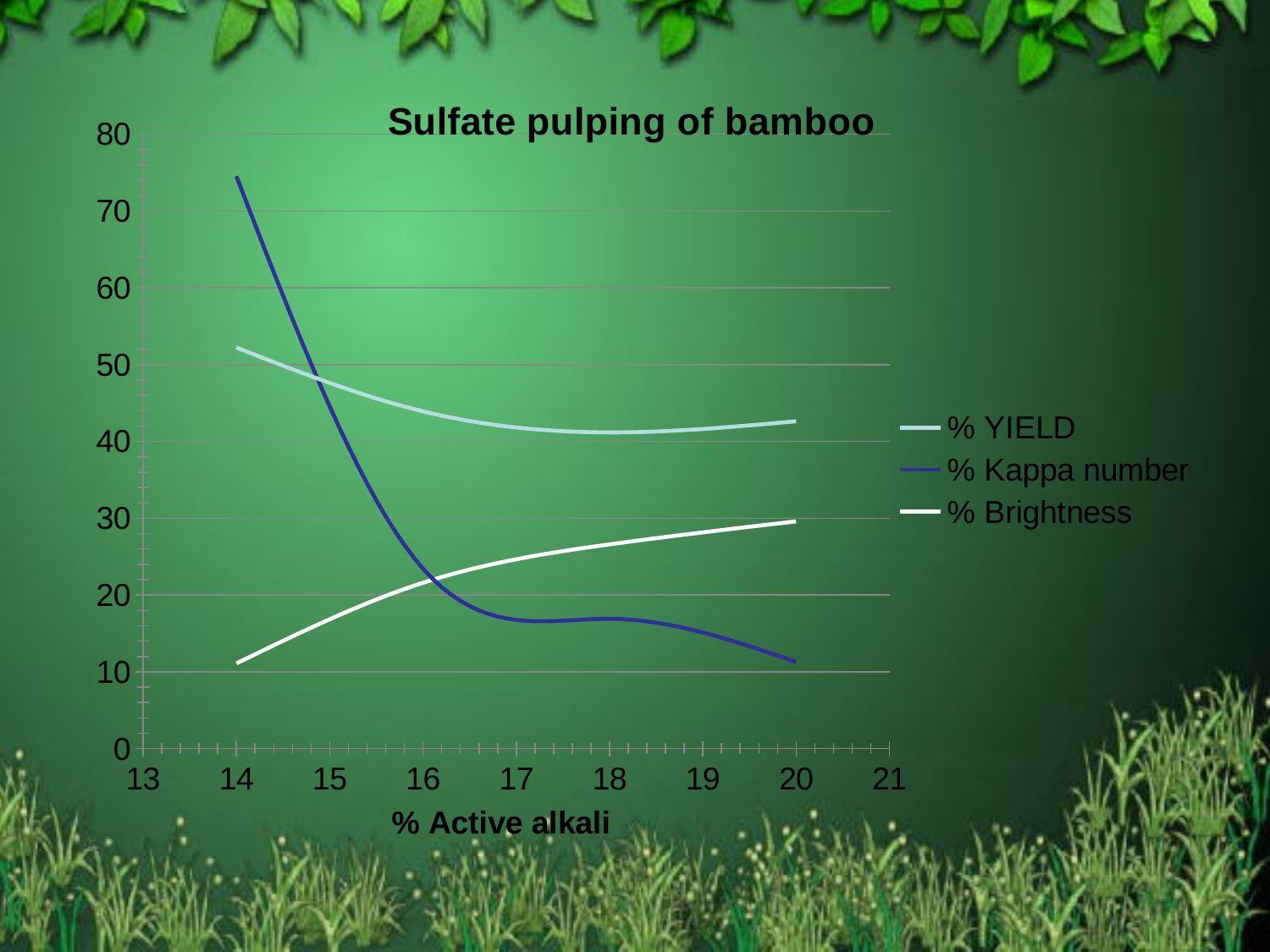
Does % Kappa number rise or fall as % active alkali increases from 14 to 20? fall At 20% active alkali, which is larger, % YIELD or % Kappa number? % YIELD At 14% active alkali, which series has the highest value? % Kappa number What kind of chart is shown on the slide? line chart Does % Brightness rise or fall as % active alkali increases from 14 to 20? rise What is the label of the x axis? % Active alkali Is the value for % Brightness at 14% active alkali greater or less than 20? less Is the value for % YIELD at 20% active alkali greater or less than 40? greater Is the value for % Kappa number at 14% active alkali greater or less than 70? greater How many series does the legend list? 3 What is the title of the chart? Sulfate pulping of bamboo